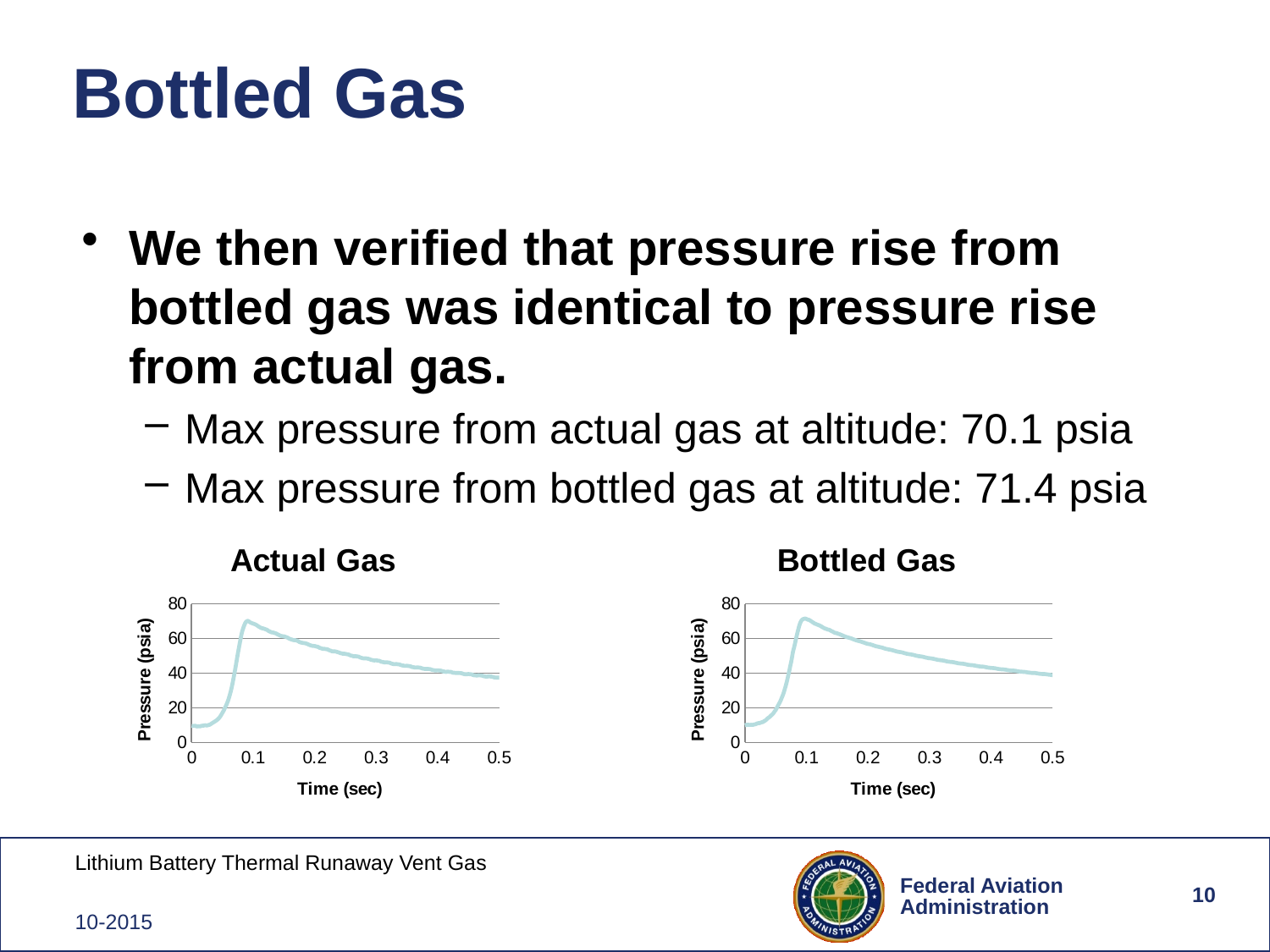
In the Actual Gas chart, is the peak pressure greater or less than 60 psia? greater In the Bottled Gas chart, is the peak pressure greater or less than 80 psia? less What kind of chart is the Actual Gas chart? line chart In the Actual Gas chart, is the pressure at 0.3 sec greater or less than 40 psia? greater According to the slide, what is the max pressure from actual gas at altitude? 70.1 psia In the Bottled Gas chart, what is the label of the x axis? Time (sec) In the Bottled Gas chart, how does the pressure change after its peak near 0.1 sec? it falls According to the slide, what is the max pressure from bottled gas at altitude? 71.4 psia How many charts are shown on the slide? 2 What kind of chart is the Bottled Gas chart? line chart In the Actual Gas chart, what is the label of the y axis? Pressure (psia)